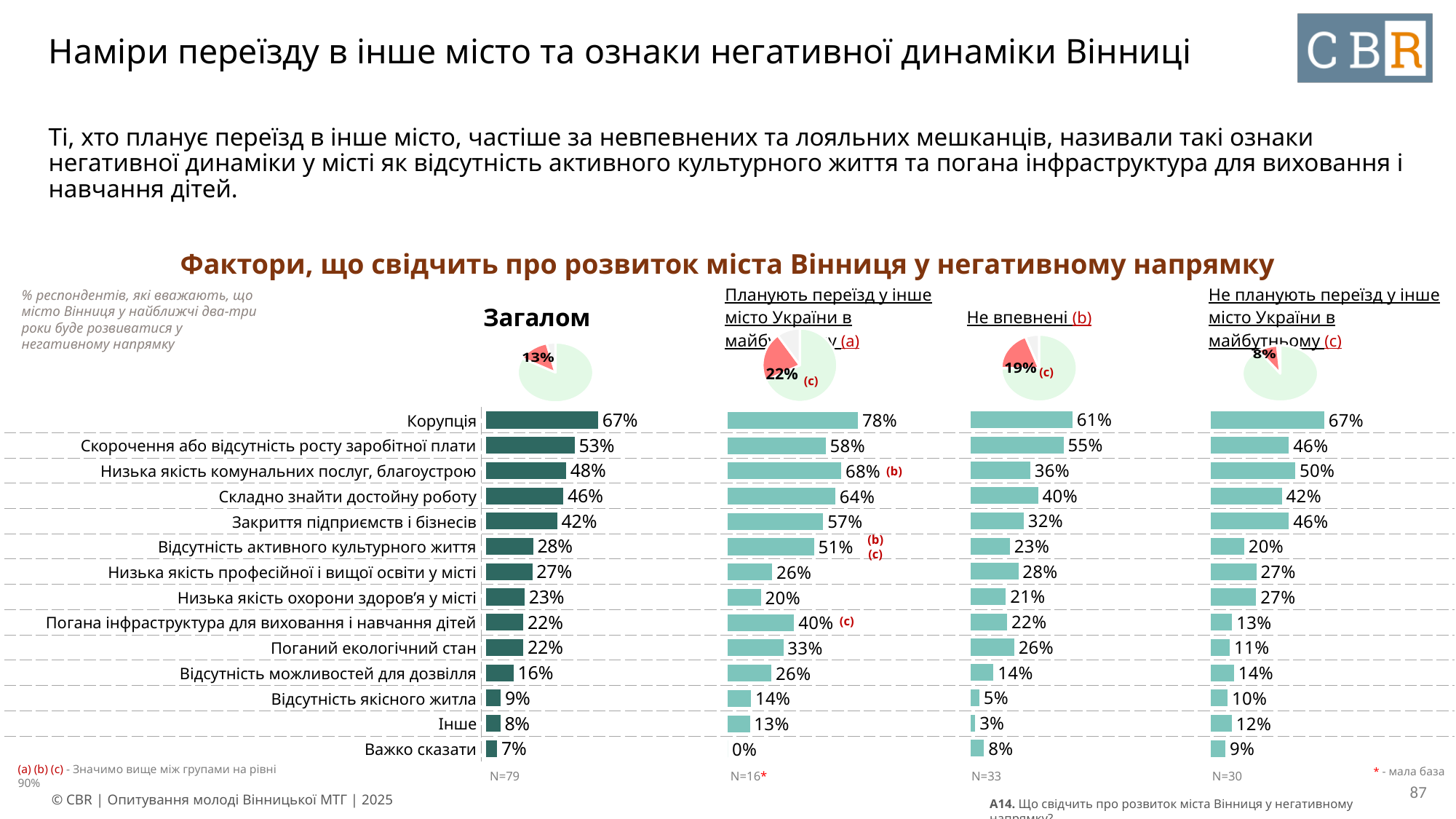
In the "Не впевнені (b)" chart, what is the value for "Відсутність якісного житла"? 5% In the "Загалом" chart, what is the value for "Корупція"? 67% In the "Загалом" chart, which category has the highest value? Корупція What kind of chart is used to show the factors in the "Загалом" section? Bar chart What is the sample size (N) shown under the "Не впевнені (b)" chart? N=33 In the "Планують переїзд у інше місто України в майбутньому (a)" chart, what is the value for "Низька якість комунальних послуг, благоустрою"? 68% How many categories are listed in the "Загалом" bar chart? 14 In the "Планують переїзд у інше місто України в майбутньому (a)" chart, what is the difference between the values for "Корупція" and "Складно знайти достойну роботу"? 14% In the "Не планують переїзд у інше місто України в майбутньому (c)" chart, which is larger: the value for "Низька якість комунальних послуг, благоустрою" or the value for "Скорочення або відсутність росту заробітної плати"? Низька якість комунальних послуг, благоустрою In the "Планують переїзд у інше місто України в майбутньому (a)" chart, what is the value for "Важко сказати"? 0% In the "Не впевнені (b)" chart, which category has the lowest value? Інше In the "Не планують переїзд у інше місто України в майбутньому (c)" chart, what is the value for "Поганий екологічний стан"? 11%